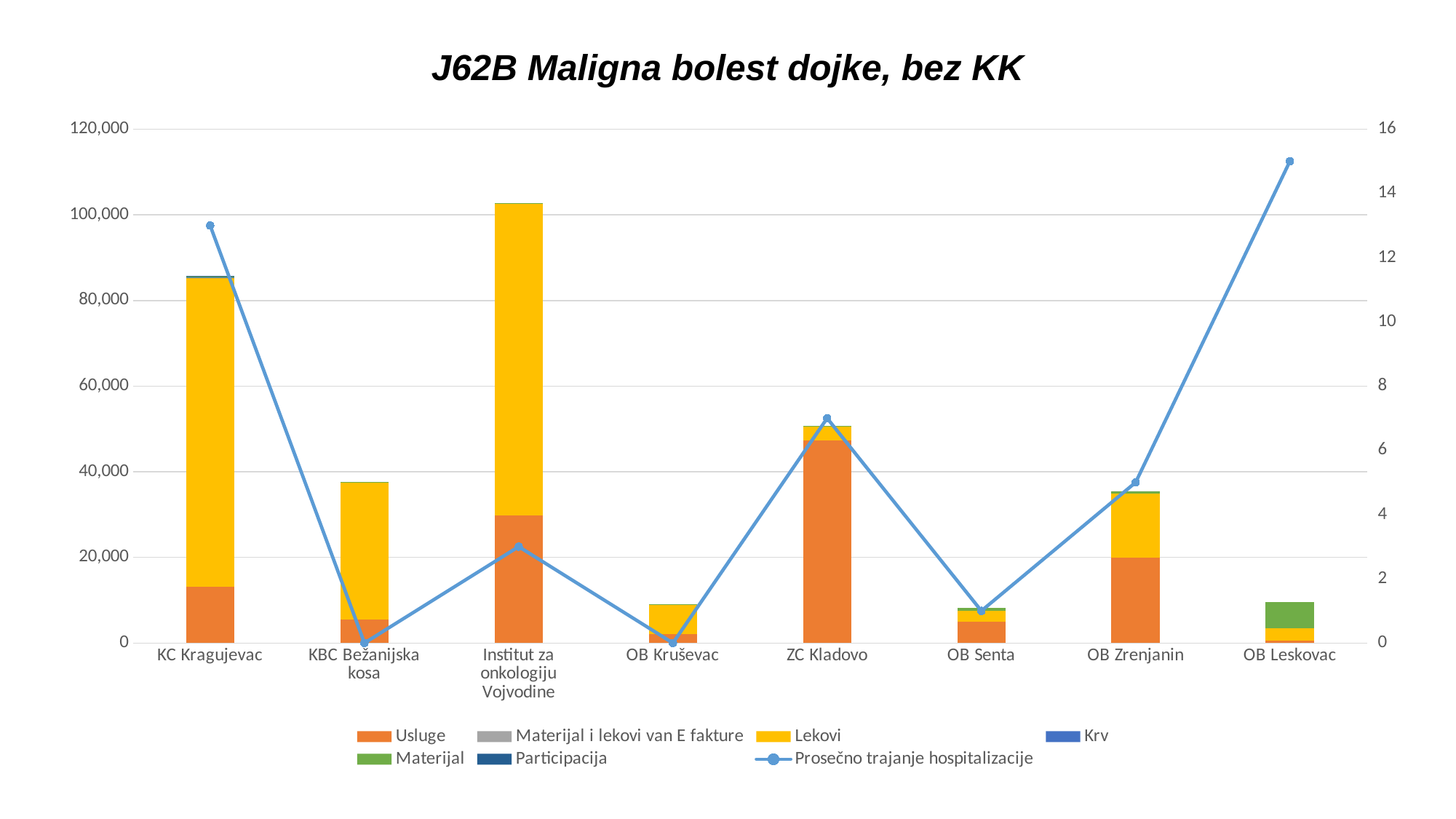
What kind of chart is this? Stacked bar chart with a line Is the total stacked bar for KC Kragujevac greater or less than 100,000? less Is the Prosečno trajanje hospitalizacije value for OB Leskovac greater or less than 14? greater Is the total stacked bar for Institut za onkologiju Vojvodine greater or less than 100,000? greater Which series is shown as a line with markers in the legend? Prosečno trajanje hospitalizacije Which institution has the highest value on the Prosečno trajanje hospitalizacije line? OB Leskovac How many categories (institutions) are shown on the x axis? 8 How many series does the legend list? 7 What is the title of the chart? J62B Maligna bolest dojke, bez KK Which institution has the tallest stacked bar? Institut za onkologiju Vojvodine Which has the larger total stacked bar, KC Kragujevac or KBC Bežanijska kosa? KC Kragujevac